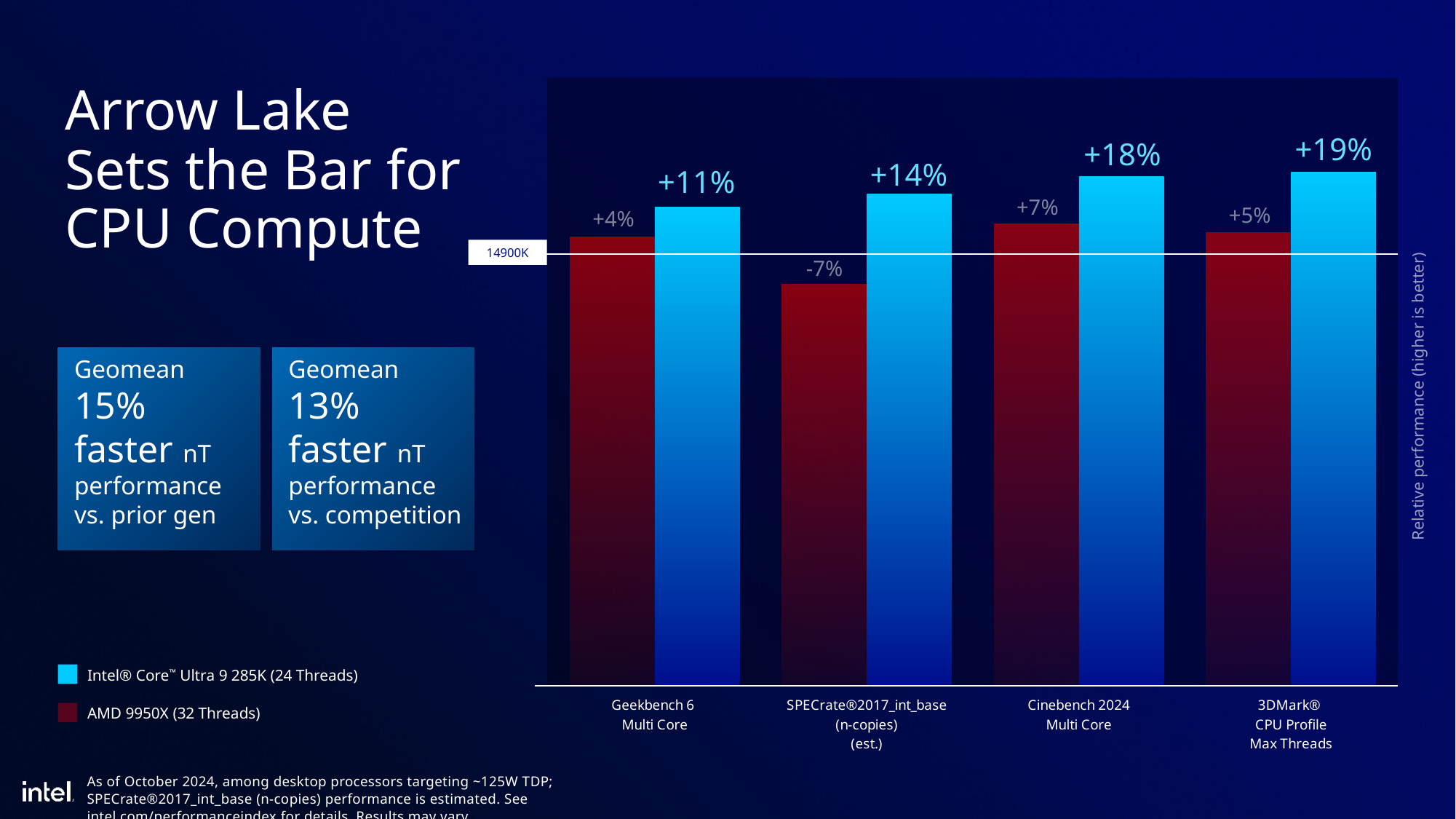
What is the data label for AMD 9950X on SPECrate®2017_int_base (n-copies) (est.)? -7% What kind of chart is shown on the slide? Bar chart What is the difference between the Intel Core Ultra 9 285K and AMD 9950X data labels on Cinebench 2024 Multi Core? 11 percentage points How many series does the legend list? 2 Which has the larger data label on Geekbench 6 Multi Core, Intel Core Ultra 9 285K or AMD 9950X? Intel Core Ultra 9 285K On which benchmark does the AMD 9950X have its lowest data label? SPECrate®2017_int_base (n-copies) (est.) What is the data label for Intel Core Ultra 9 285K on Cinebench 2024 Multi Core? +18% What is the data label for AMD 9950X on Geekbench 6 Multi Core? +4% How many benchmarks are shown on the x axis of the chart? 4 On which benchmark does the Intel Core Ultra 9 285K have its highest data label? 3DMark® CPU Profile Max Threads What baseline processor does the horizontal reference line on the chart represent? 14900K What is the data label for Intel Core Ultra 9 285K on 3DMark® CPU Profile Max Threads? +19%